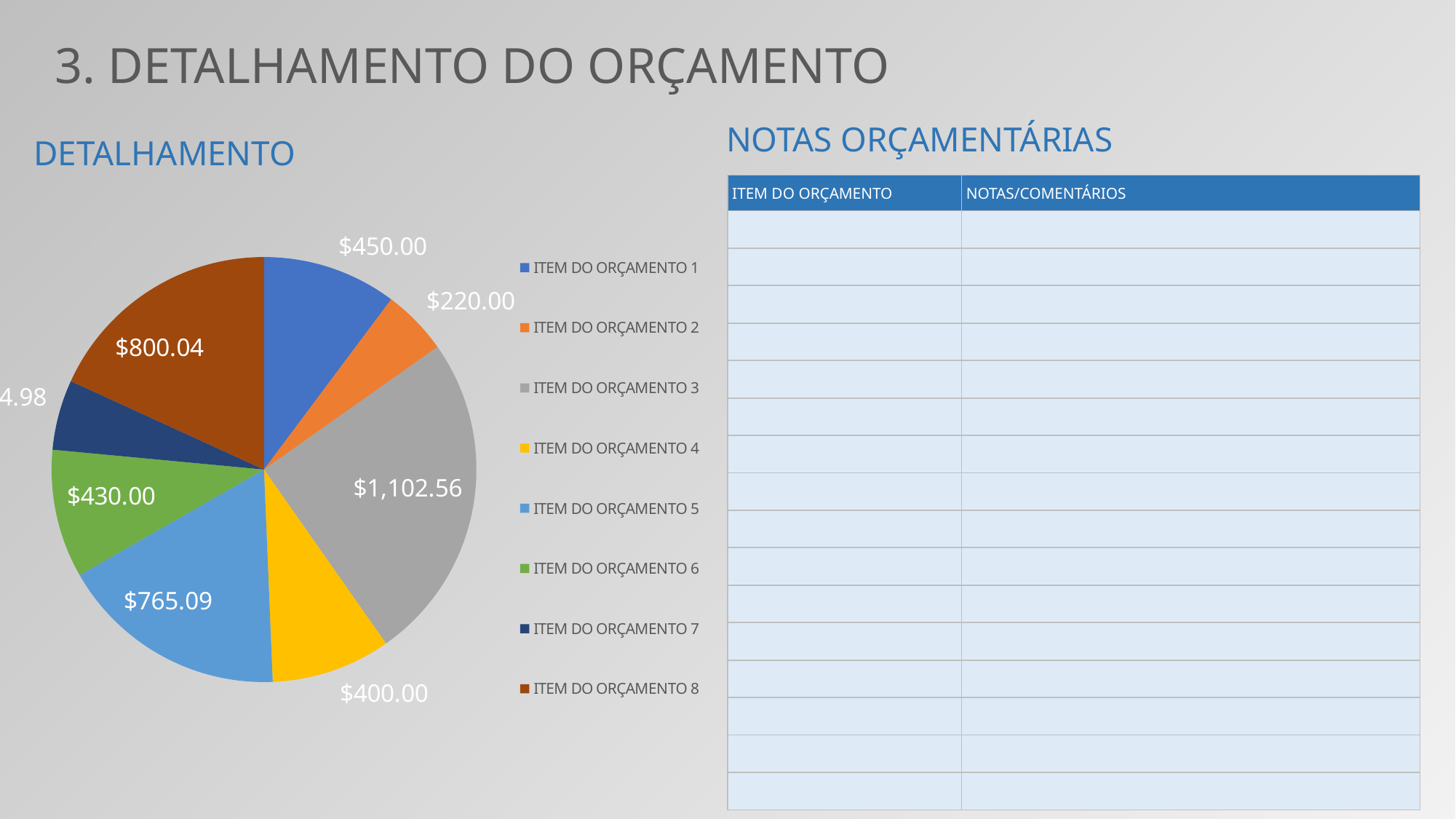
Which is larger in the pie chart: ITEM DO ORÇAMENTO 5 or ITEM DO ORÇAMENTO 4? ITEM DO ORÇAMENTO 5 What is the value for ITEM DO ORÇAMENTO 2 in the pie chart? $220.00 What is the value for ITEM DO ORÇAMENTO 8 in the pie chart? $800.04 Which budget item has the largest slice in the pie chart? ITEM DO ORÇAMENTO 3 What is the difference between the values for ITEM DO ORÇAMENTO 3 and ITEM DO ORÇAMENTO 1? $652.56 What type of chart is shown under the heading DETALHAMENTO? pie chart What is the value for ITEM DO ORÇAMENTO 3 in the pie chart? $1,102.56 What is the value for ITEM DO ORÇAMENTO 1 in the pie chart? $450.00 How many budget items are shown in the pie chart? 8 What colour is the slice for ITEM DO ORÇAMENTO 6 in the pie chart? green What is the value for ITEM DO ORÇAMENTO 5 in the pie chart? $765.09 What is the difference between the values for ITEM DO ORÇAMENTO 8 and ITEM DO ORÇAMENTO 5? $34.95